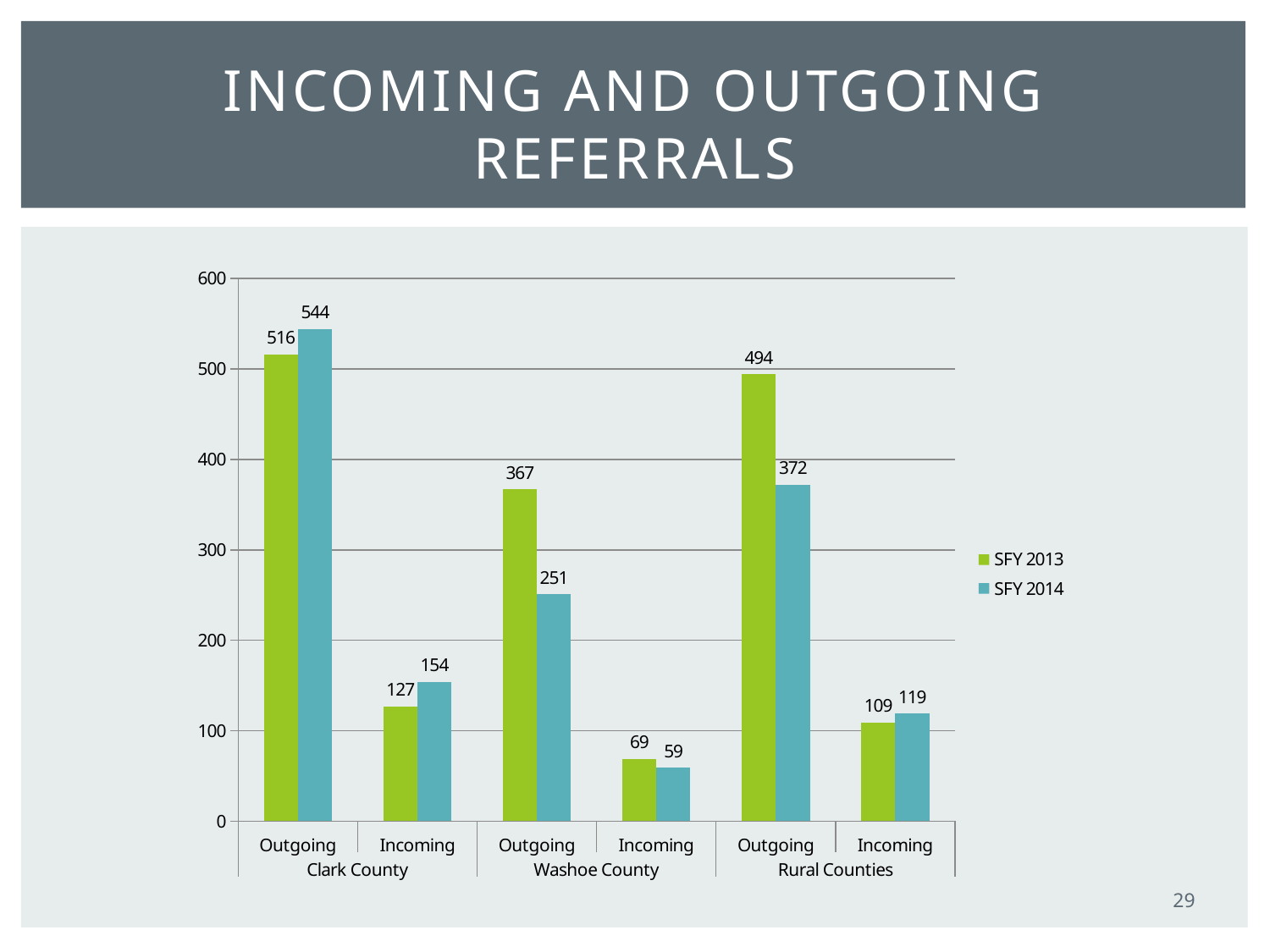
What kind of chart is shown on the slide? Bar chart What is the difference between the SFY 2013 and SFY 2014 values for Washoe County Outgoing referrals? 116 What is the SFY 2014 value for Clark County Outgoing referrals? 544 How many series does the legend list? 2 What is the difference between the SFY 2013 and SFY 2014 values for Rural Counties Outgoing referrals? 122 What is the SFY 2013 value for Washoe County Incoming referrals? 69 Which is larger for Clark County Incoming referrals: SFY 2013 or SFY 2014? SFY 2014 Which category has the lowest SFY 2013 value? Washoe County Incoming Which category has the highest SFY 2014 value? Clark County Outgoing What is the title of the slide? Incoming and Outgoing Referrals Is the SFY 2014 value for Rural Counties Outgoing referrals greater or less than 400? less What is the SFY 2013 value for Rural Counties Outgoing referrals? 494